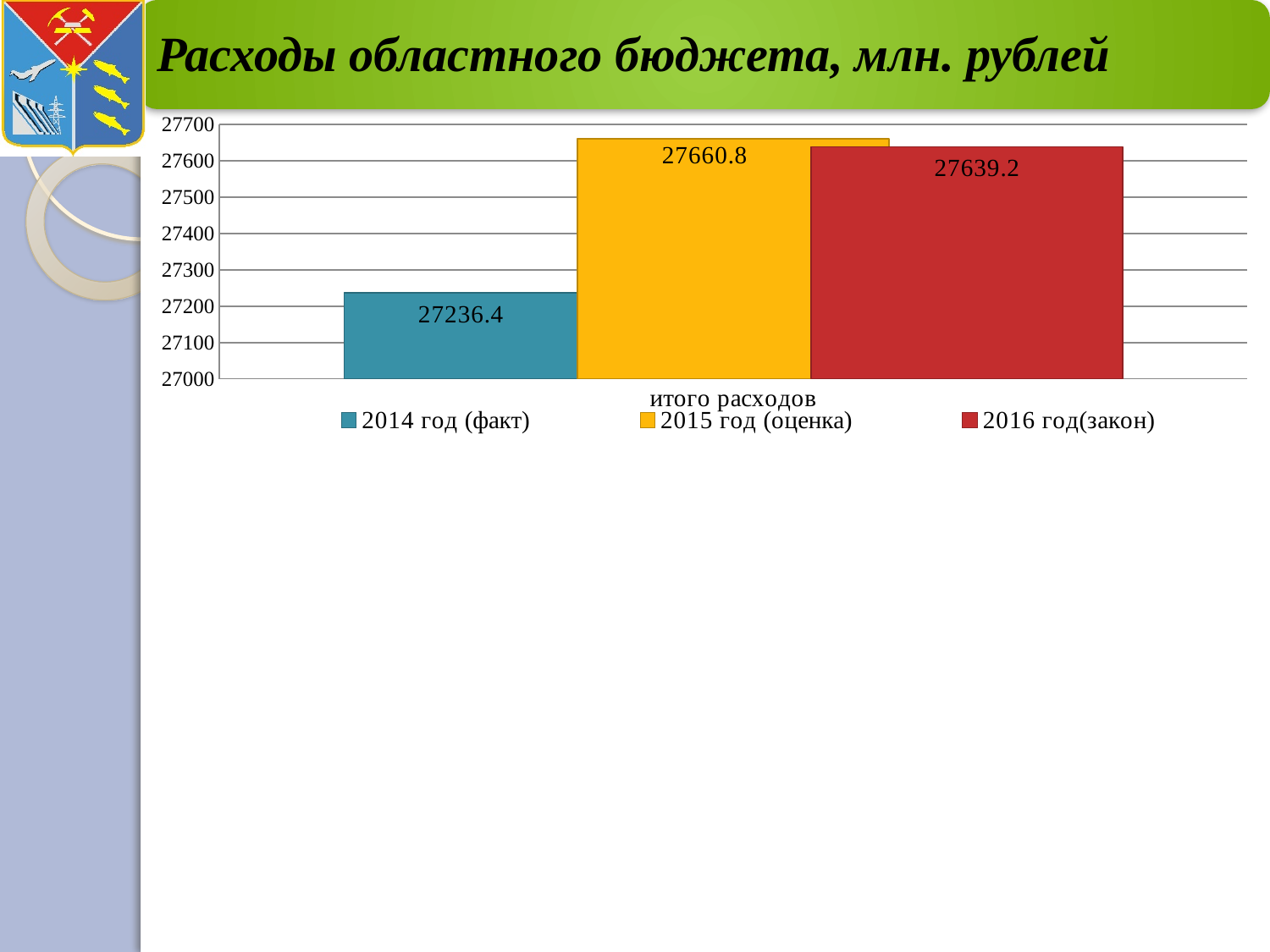
What is the difference between the values for 2015 год (оценка) and 2016 год(закон)? 21.6 What is the difference between the values for 2015 год (оценка) and 2014 год (факт)? 424.4 How many series does the legend list? 3 What is the value for 2014 год (факт)? 27236.4 What is the title of the chart? Расходы областного бюджета, млн. рублей Which series has the highest value? 2015 год (оценка) Which series has the lowest value? 2014 год (факт) Which is larger, the value for 2016 год(закон) or the value for 2014 год (факт)? 2016 год(закон) Is the value for 2014 год (факт) greater or less than 27300? less What is the value for 2015 год (оценка)? 27660.8 What is the value for 2016 год(закон)? 27639.2 What kind of chart is shown on the slide? bar chart